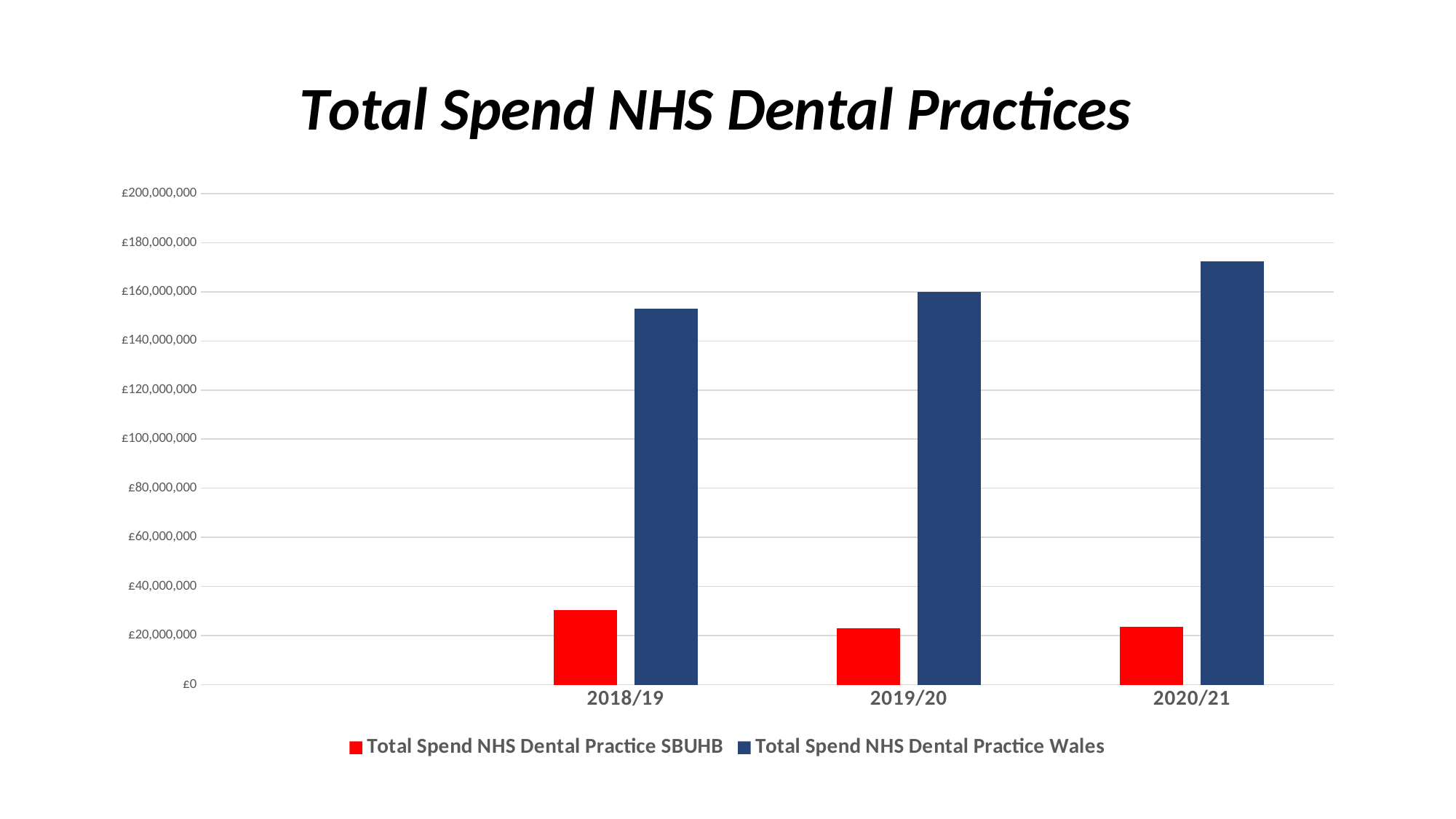
Is the value for Total Spend NHS Dental Practice Wales in 2018/19 greater or less than £140,000,000? greater Does Total Spend NHS Dental Practice Wales rise or fall from 2018/19 to 2020/21? rise How many financial years are shown on the x axis? 3 What kind of chart is shown on the slide? bar chart Is the value for Total Spend NHS Dental Practice SBUHB in 2018/19 greater or less than £40,000,000? less In which year is Total Spend NHS Dental Practice SBUHB highest? 2018/19 Which colour represents Total Spend NHS Dental Practice Wales? dark blue How many series does the legend list? 2 In which year is Total Spend NHS Dental Practice Wales highest? 2020/21 Is the value for Total Spend NHS Dental Practice Wales in 2020/21 greater or less than £160,000,000? greater What is the title of the chart? Total Spend NHS Dental Practices